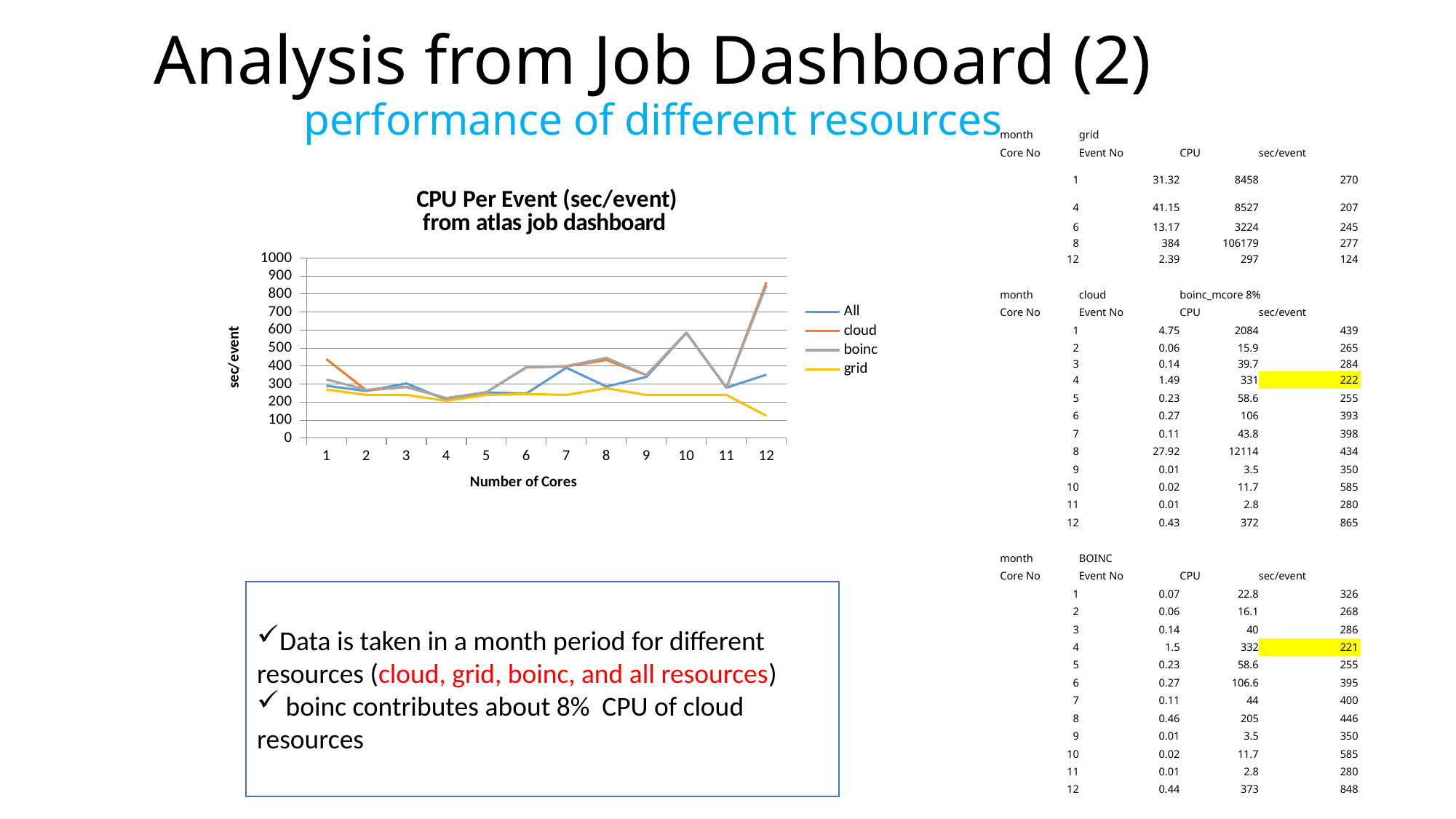
What is the title of the chart? CPU Per Event (sec/event) from atlas job dashboard Is the value for cloud at 12 cores greater or less than 800? greater Is the value for grid at 12 cores greater or less than 200? less How many points along the Number of Cores axis does the chart show? 12 At which number of cores does the grid series reach its lowest value? 12 At which number of cores does the cloud series reach its highest value? 12 Is the value for cloud at 1 core greater or less than 400? greater At 10 cores, which series has the larger value, boinc or grid? boinc What kind of chart is shown on the slide? line chart What is the label of the vertical axis of the chart? sec/event Does the grid series rise or fall from 11 cores to 12 cores? fall How many series does the chart legend list? 4